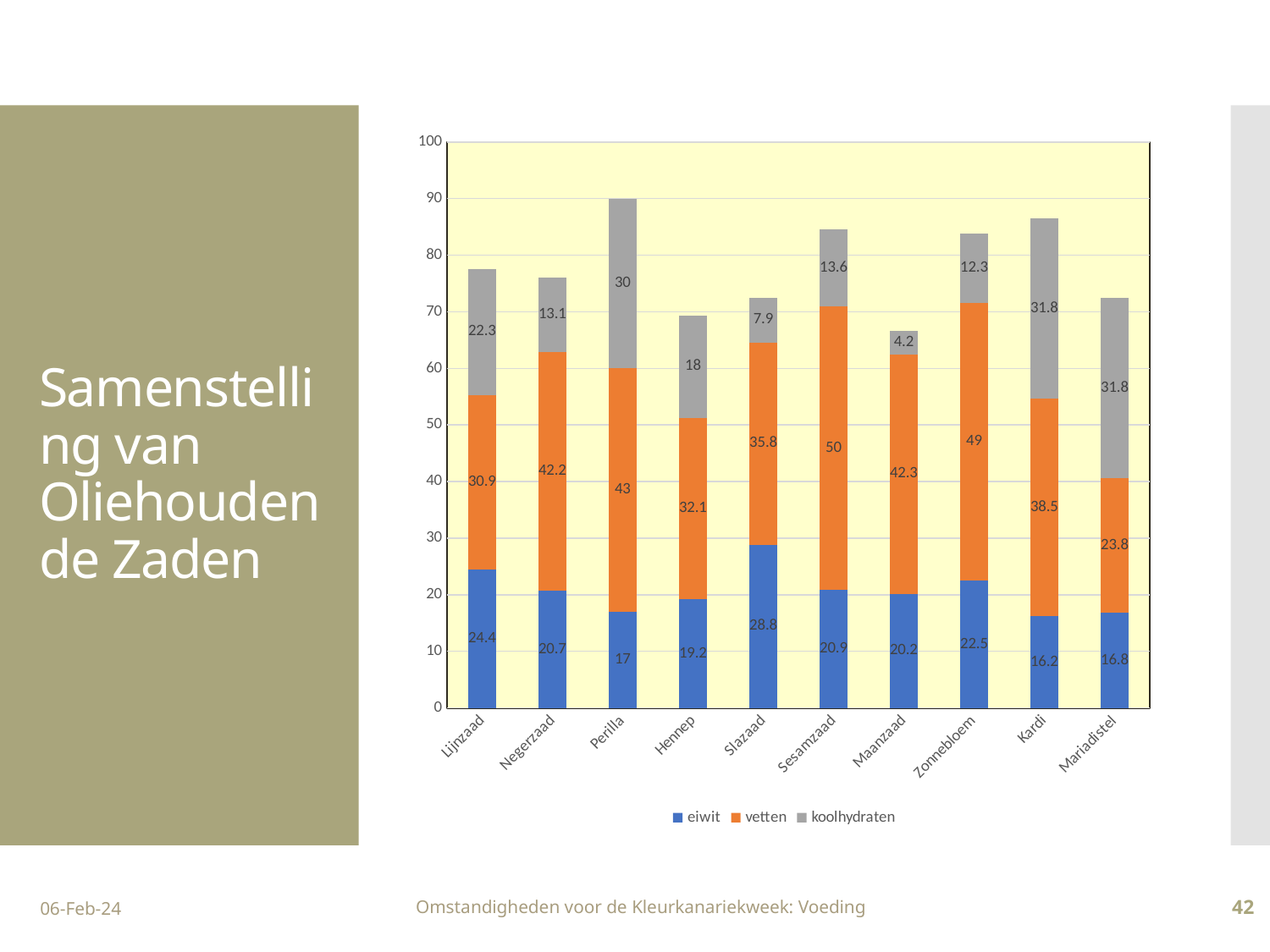
How many seed categories are shown on the x axis? 10 What is the vetten value for Sesamzaad? 50 Which category has the highest eiwit value? Slazaad What is the difference between the vetten values of Perilla and Negerzaad? 0.8 Which is larger, the eiwit value for Lijnzaad or the eiwit value for Zonnebloem? Lijnzaad What type of chart is shown on the slide? stacked bar chart Which category has the lowest vetten value? Mariadistel What is the eiwit value for Slazaad? 28.8 What is the koolhydraten value for Maanzaad? 4.2 What is the total of the stacked bar for Perilla? 90 Which category has the lowest koolhydraten value? Maanzaad How many series does the legend list? 3